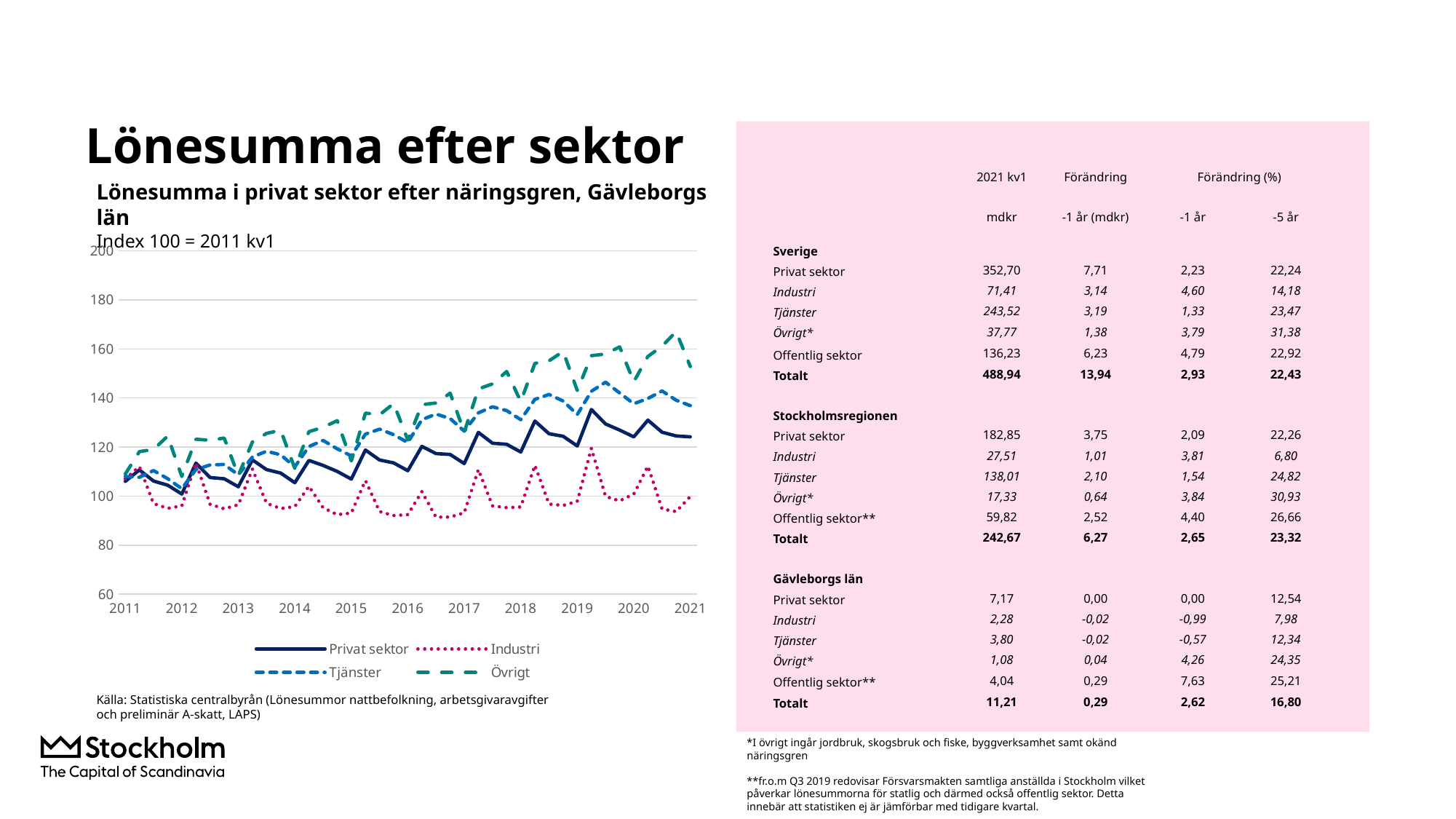
How many year labels are shown on the x axis of the chart? 11 What is the base of the index used in the chart, according to the subtitle? Index 100 = 2011 kv1 Is the value for Övrigt at the end of 2020 greater or less than 140? greater Which series has the lowest value at the end of the chart in 2021? Industri Is the value for Privat sektor in 2021 greater or less than 140? less Does the Övrigt series generally rise or fall from 2011 to 2021? rise Which series has the highest value at the end of the chart in 2021? Övrigt Which series are listed in the chart's legend? Privat sektor, Industri, Tjänster, Övrigt What kind of chart is shown on the slide? line chart In 2020, which is larger, the value for Övrigt or the value for Industri? Övrigt Is the value for Industri at the start of 2021 greater or less than 120? less How many series does the legend of the chart list? 4